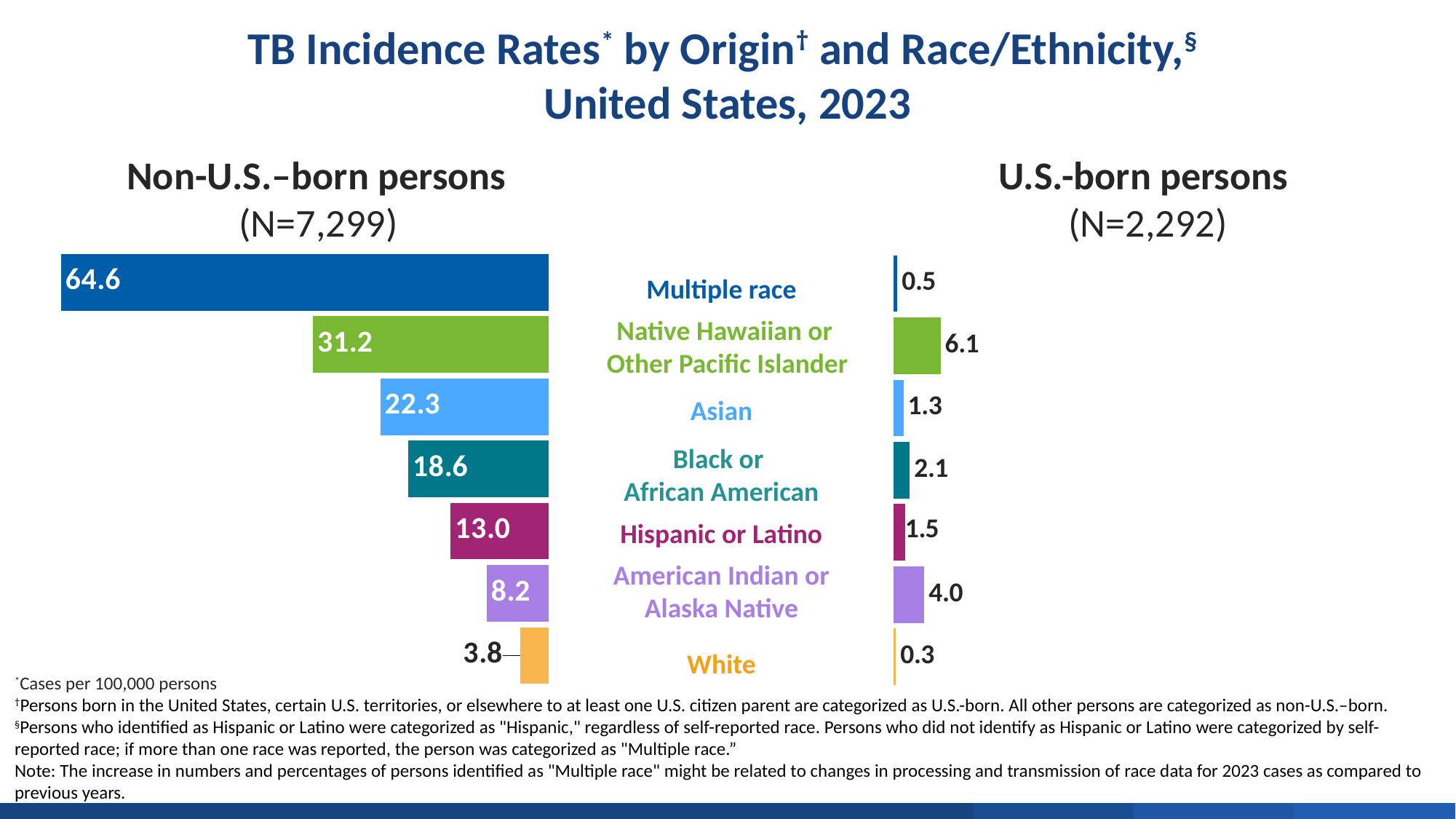
In the U.S.-born persons chart, which race/ethnicity category has the highest TB incidence rate? Native Hawaiian or Other Pacific Islander Which is larger: the rate for White persons among Non-U.S.–born persons or among U.S.-born persons? Non-U.S.–born persons In the U.S.-born persons chart, what is the TB incidence rate for American Indian or Alaska Native persons? 4.0 What is the N value shown for U.S.-born persons? N=2,292 In the Non-U.S.–born persons chart, what is the TB incidence rate for Asian persons? 22.3 In the U.S.-born persons chart, what is the difference between the rates for Black or African American and Hispanic or Latino persons? 0.6 In the Non-U.S.–born persons chart, what is the difference between the rates for Multiple race and Native Hawaiian or Other Pacific Islander persons? 33.4 In the Non-U.S.–born persons chart, which race/ethnicity category has the highest TB incidence rate? Multiple race What kind of chart is used to show the TB incidence rates on this slide? Bar chart How many race/ethnicity categories are shown in the Non-U.S.–born persons chart? 7 In the U.S.-born persons chart, which race/ethnicity category has the lowest TB incidence rate? White In the Non-U.S.–born persons chart, which is larger: the rate for Black or African American persons or the rate for Hispanic or Latino persons? Black or African American